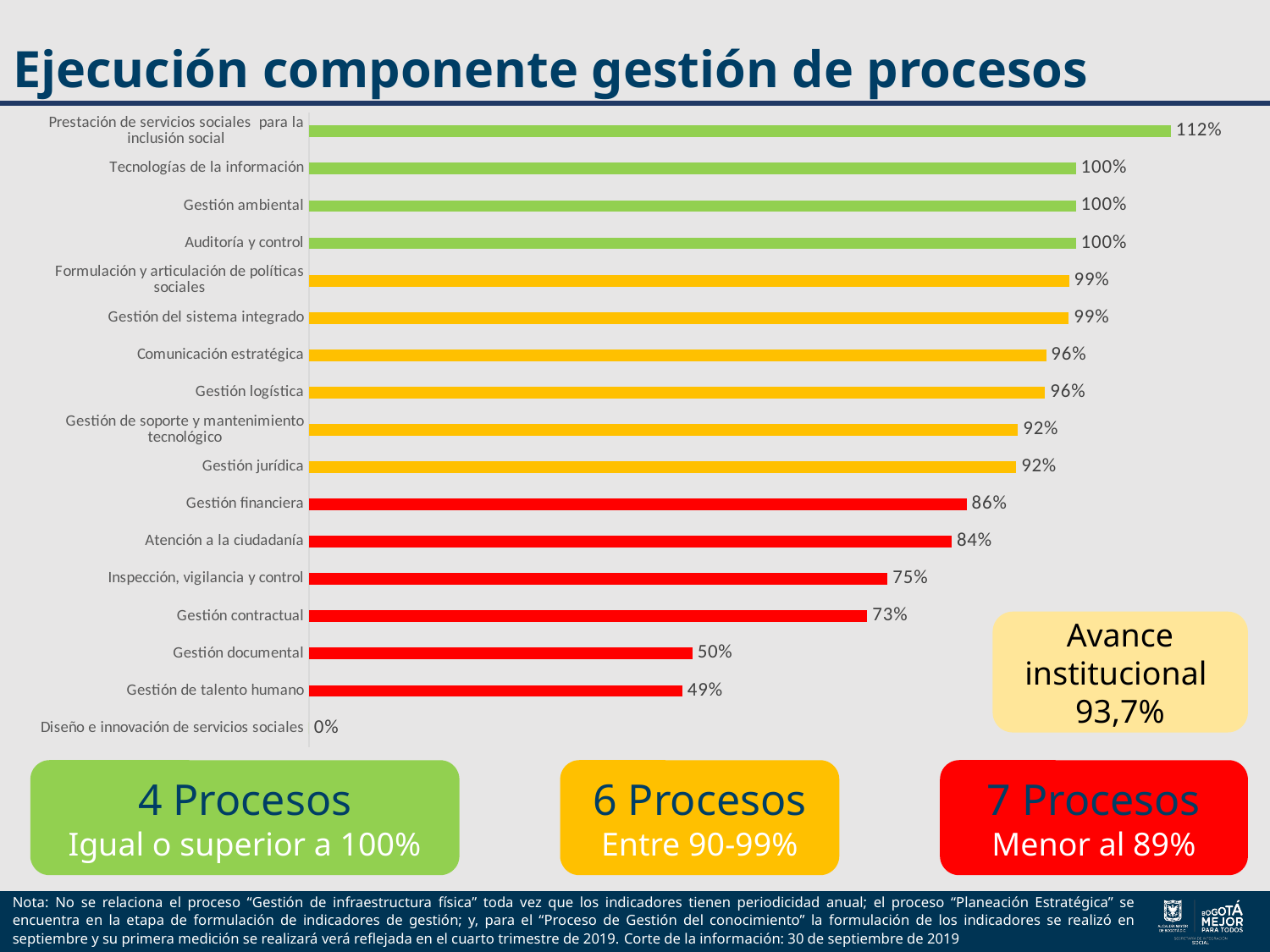
What is the value for Comunicación estratégica? 96% What is the value for Gestión financiera? 86% How many categories are shown in the chart? 17 What colour are the bars for the processes with values below 89%? Red What kind of chart is shown on the slide? Bar chart Which is larger, the value for Atención a la ciudadanía or the value for Inspección, vigilancia y control? Atención a la ciudadanía Which category has the highest value? Prestación de servicios sociales para la inclusión social Which category has the lowest value? Diseño e innovación de servicios sociales What is the value for Gestión de talento humano? 49% What is the title of the slide? Ejecución componente gestión de procesos What is the difference between the values for Gestión contractual and Gestión documental? 23% What is the difference between the values for Prestación de servicios sociales para la inclusión social and Tecnologías de la información? 12%